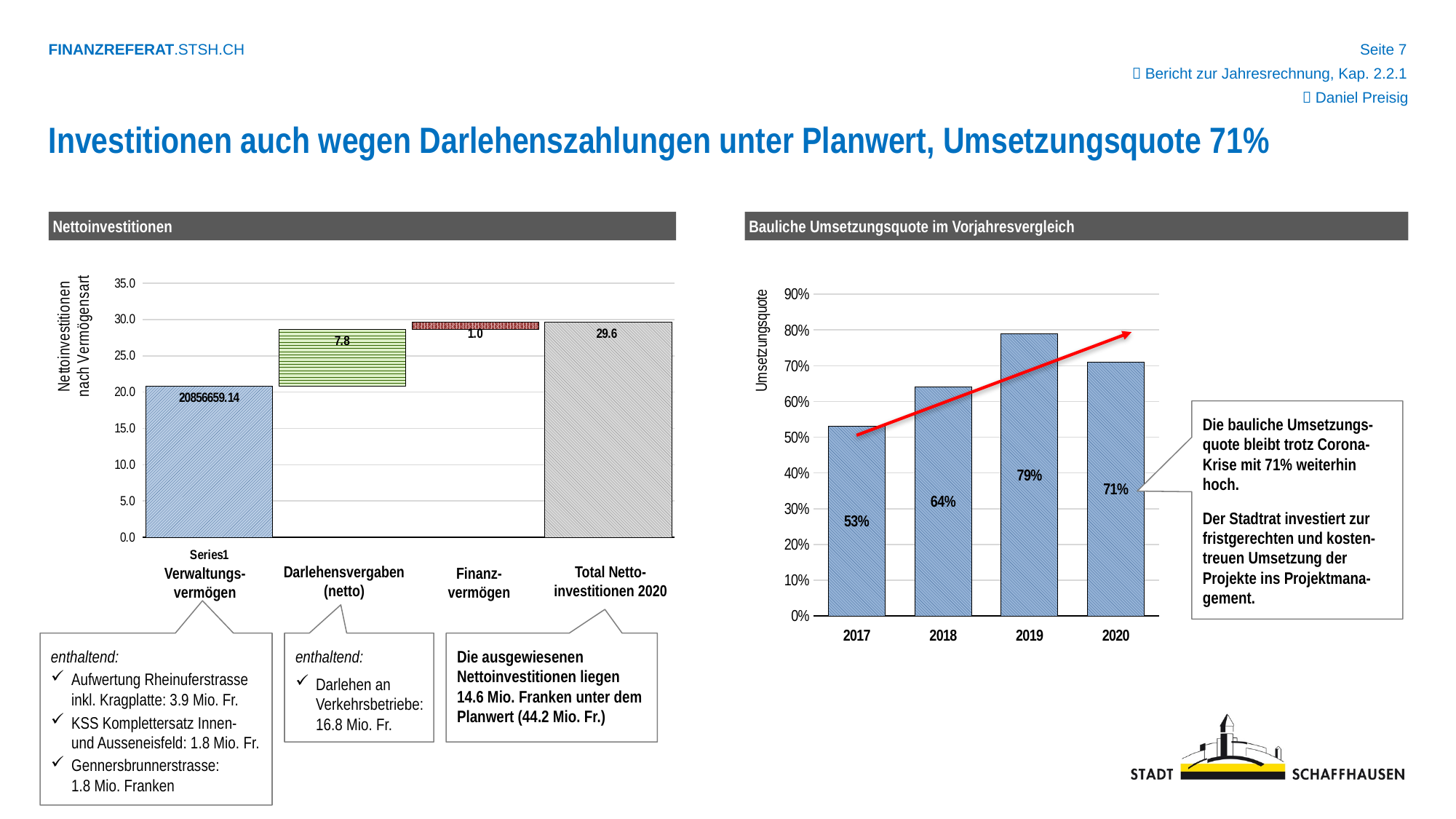
How many years are shown in the 'Bauliche Umsetzungsquote im Vorjahresvergleich' chart? 4 What type of chart is the 'Bauliche Umsetzungsquote im Vorjahresvergleich' chart? bar chart In the 'Bauliche Umsetzungsquote im Vorjahresvergleich' chart, which year has the highest value? 2019 In the 'Nettoinvestitionen' chart, what is the value labelled on the 'Finanzvermögen' bar? 1.0 In the 'Bauliche Umsetzungsquote im Vorjahresvergleich' chart, which year has the lowest value? 2017 In the 'Bauliche Umsetzungsquote im Vorjahresvergleich' chart, what is the value for 2019? 79% In the 'Bauliche Umsetzungsquote im Vorjahresvergleich' chart, what is the value for 2017? 53% In the 'Nettoinvestitionen' chart, what is the value labelled on the 'Darlehensvergaben (netto)' bar? 7.8 In the 'Nettoinvestitionen' chart, what is the label of the y axis? Nettoinvestitionen nach Vermögensart In the 'Nettoinvestitionen' chart, what is the value labelled on the 'Total Nettoinvestitionen 2020' bar? 29.6 In the 'Bauliche Umsetzungsquote im Vorjahresvergleich' chart, what is the difference between the values for 2019 and 2020? 8% In the 'Bauliche Umsetzungsquote im Vorjahresvergleich' chart, is the value for 2018 larger or smaller than the value for 2020? smaller